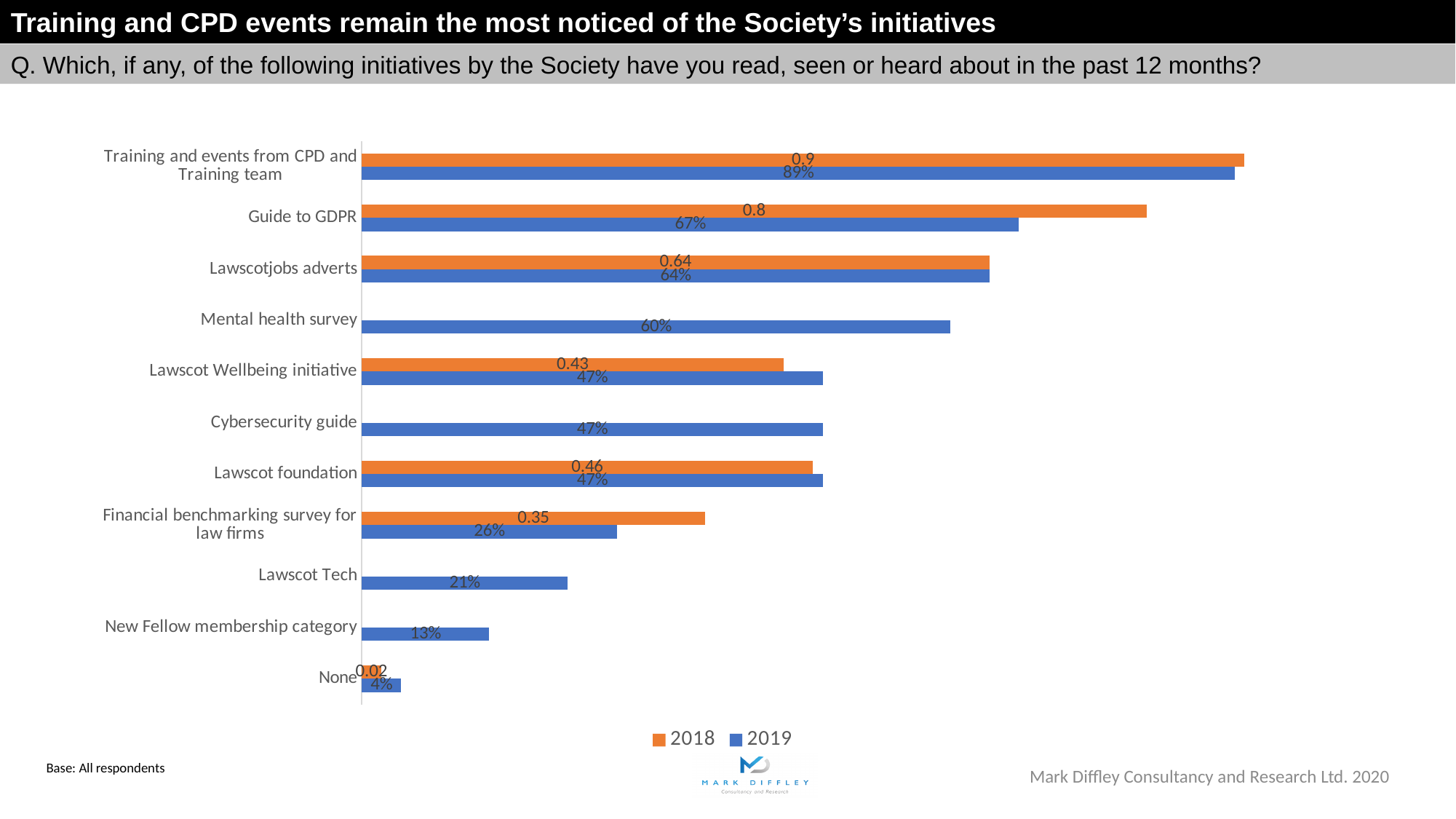
For Guide to GDPR, which year has the larger value, 2018 or 2019? 2018 What kind of chart is shown on the slide? Bar chart What is the 2019 value for Mental health survey? 60% Which initiative has the highest 2019 value? Training and events from CPD and Training team What is the 2018 value for Lawscot Wellbeing initiative? 0.43 How many initiatives (categories) are listed on the chart? 11 Which category has the lowest 2019 value? None How many series does the legend list? 2 Which colour represents the 2019 series in the legend? Blue What is the difference between the 2019 values for Training and events from CPD and Training team and Guide to GDPR? 22 percentage points What is the 2019 value for Guide to GDPR? 67% What is the 2018 value for Financial benchmarking survey for law firms? 0.35